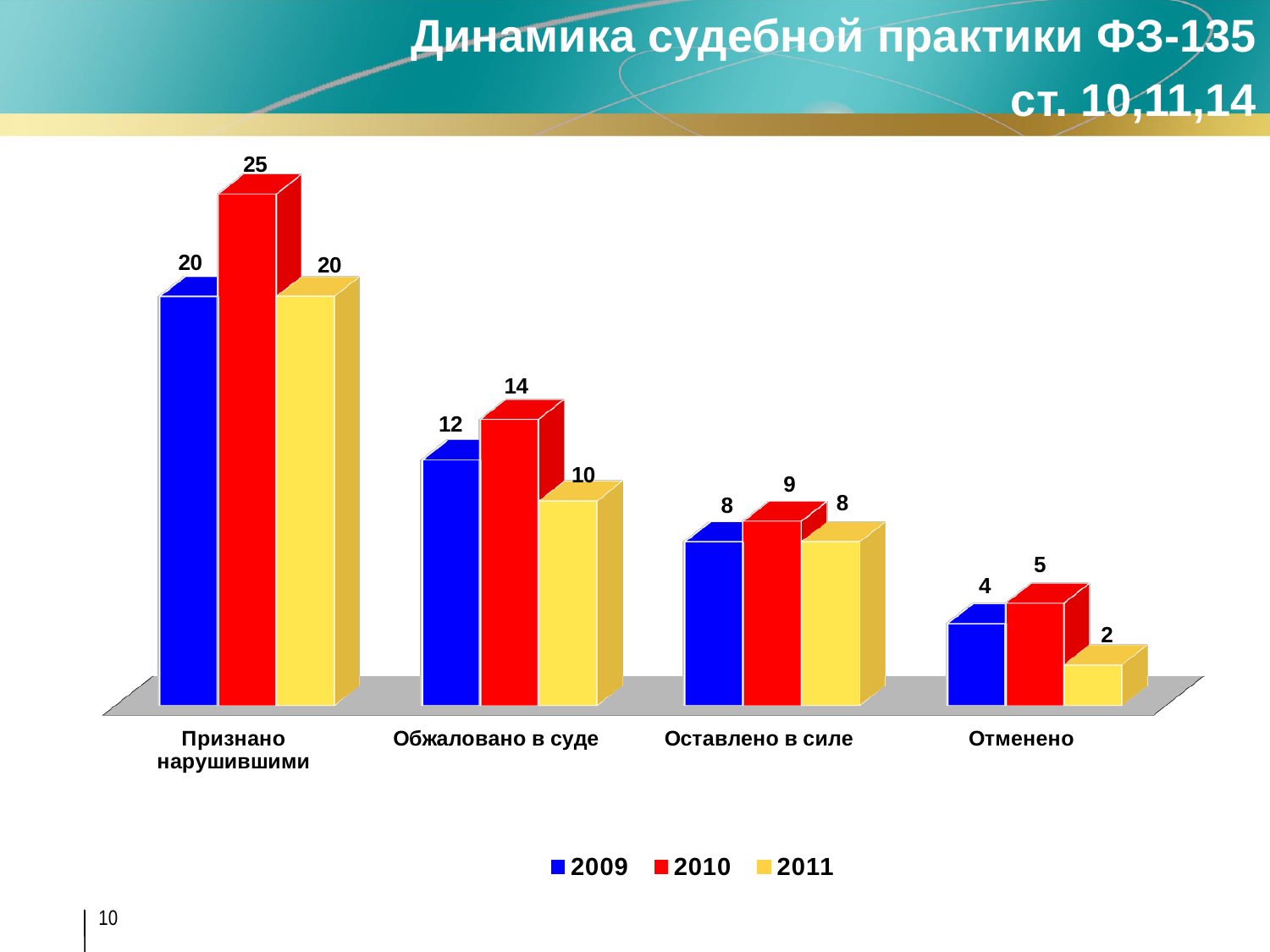
What is the difference between the 2010 and 2011 values in the 'Обжаловано в суде' category? 4 Which category has the highest value for the 2010 series? Признано нарушившими What is the value for 2010 in the 'Признано нарушившими' category? 25 Which colour represents the 2011 series in the legend? Yellow Which is larger in the 'Оставлено в силе' category: the 2010 value or the 2011 value? 2010 What kind of chart is shown on the slide? Bar chart What is the value for 2009 in the 'Отменено' category? 4 Which category has the lowest value for the 2011 series? Отменено What is the value for 2011 in the 'Обжаловано в суде' category? 10 How many categories are shown on the x axis? 4 How many series does the legend list? 3 What is the difference between the 2009 and 2011 values in the 'Отменено' category? 2